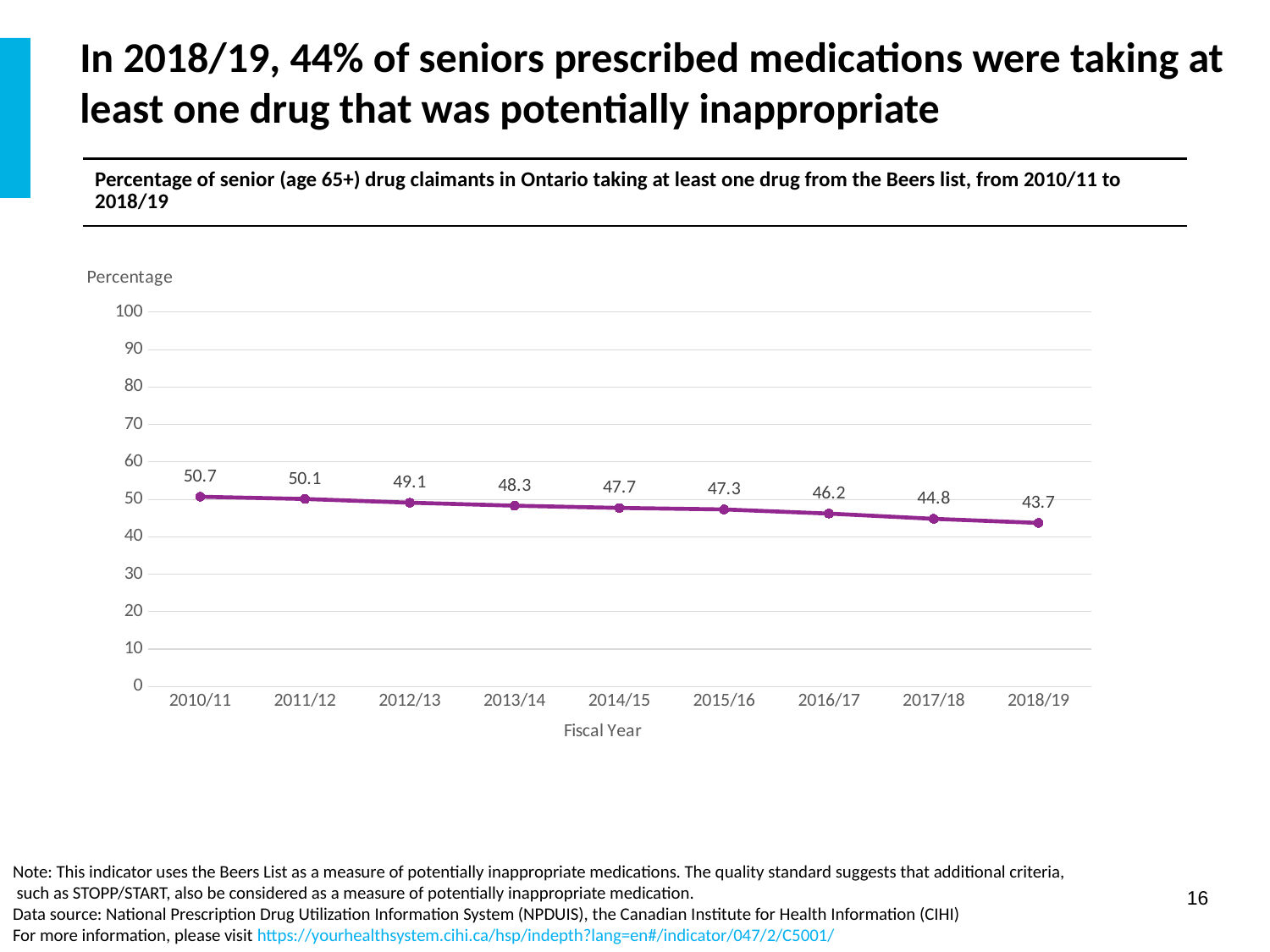
Do the values rise or fall from 2010/11 to 2018/19? fall What is the difference between the 2010/11 value and the 2018/19 value? 7.0 What is the percentage of senior drug claimants taking at least one Beers list drug in 2010/11? 50.7 What is the value plotted for fiscal year 2018/19? 43.7 Is the value for 2017/18 greater or less than 50? less Which fiscal year has the highest percentage? 2010/11 What is the difference between the values for 2016/17 and 2017/18? 1.4 What is the value plotted for fiscal year 2014/15? 47.7 How many fiscal years are plotted on the chart? 9 What kind of chart is shown on the slide? line chart Which fiscal year has the lowest percentage? 2018/19 Which is larger, the value for 2012/13 or the value for 2015/16? 2012/13